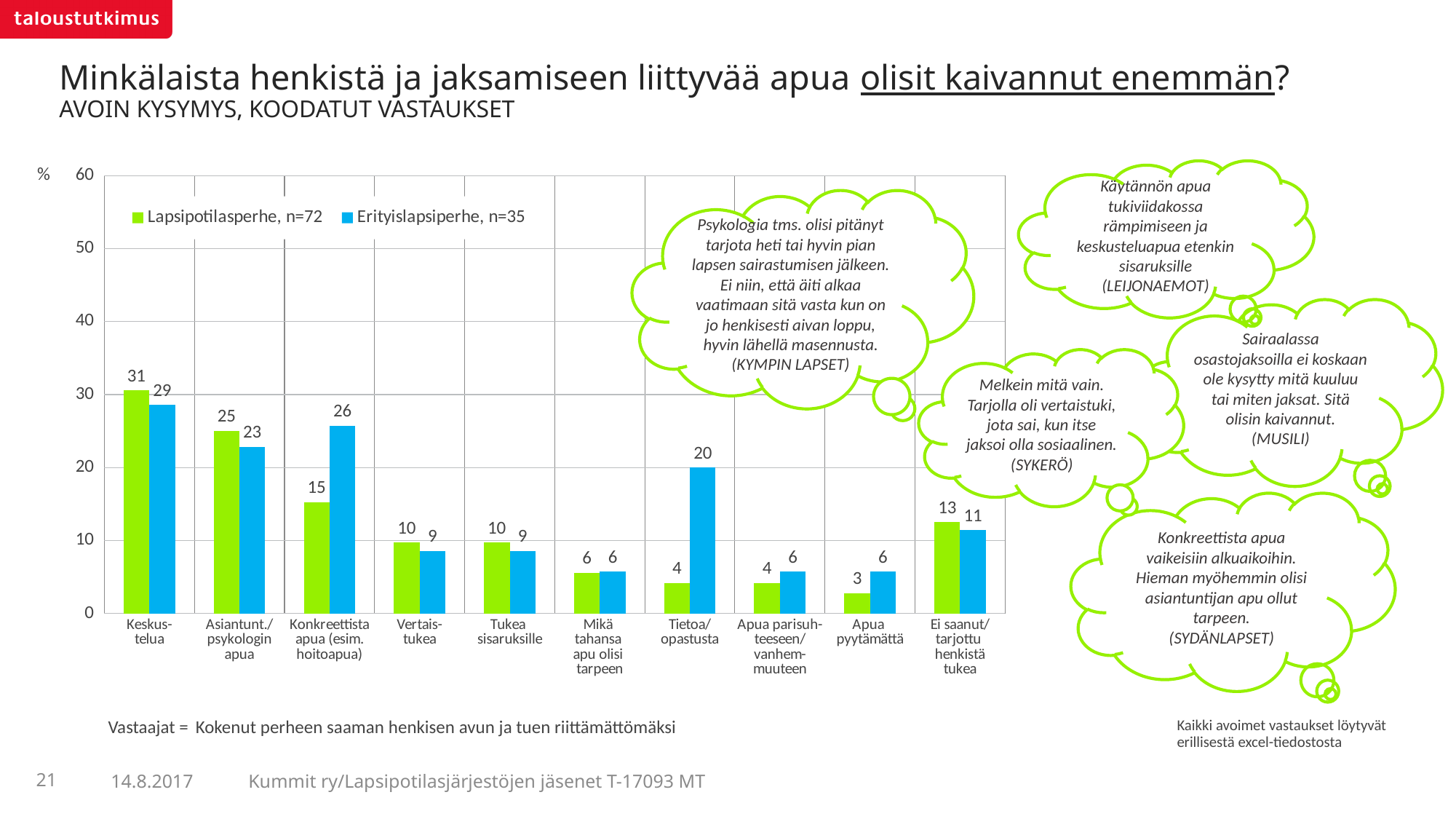
How many series does the chart legend list? 2 What is the value for Erityislapsiperhe in the Konkreettista apua (esim. hoitoapua) category? 26 In the Konkreettista apua (esim. hoitoapua) category, which series has the larger value, Lapsipotilasperhe or Erityislapsiperhe? Erityislapsiperhe What is the difference between the Erityislapsiperhe and Lapsipotilasperhe values in the Tietoa/opastusta category? 16 Is the value for Lapsipotilasperhe in the Keskustelua category greater or less than 30? greater Which category has the highest value for Lapsipotilasperhe? Keskustelua What kind of chart is shown on the slide? bar chart Which category has the lowest value for Lapsipotilasperhe? Apua pyytämättä What is the sample size (n) given in the legend for Erityislapsiperhe? n=35 How many categories are shown on the x axis of the chart? 10 What is the value for Erityislapsiperhe in the Tietoa/opastusta category? 20 What is the value for Lapsipotilasperhe in the Keskustelua category? 31